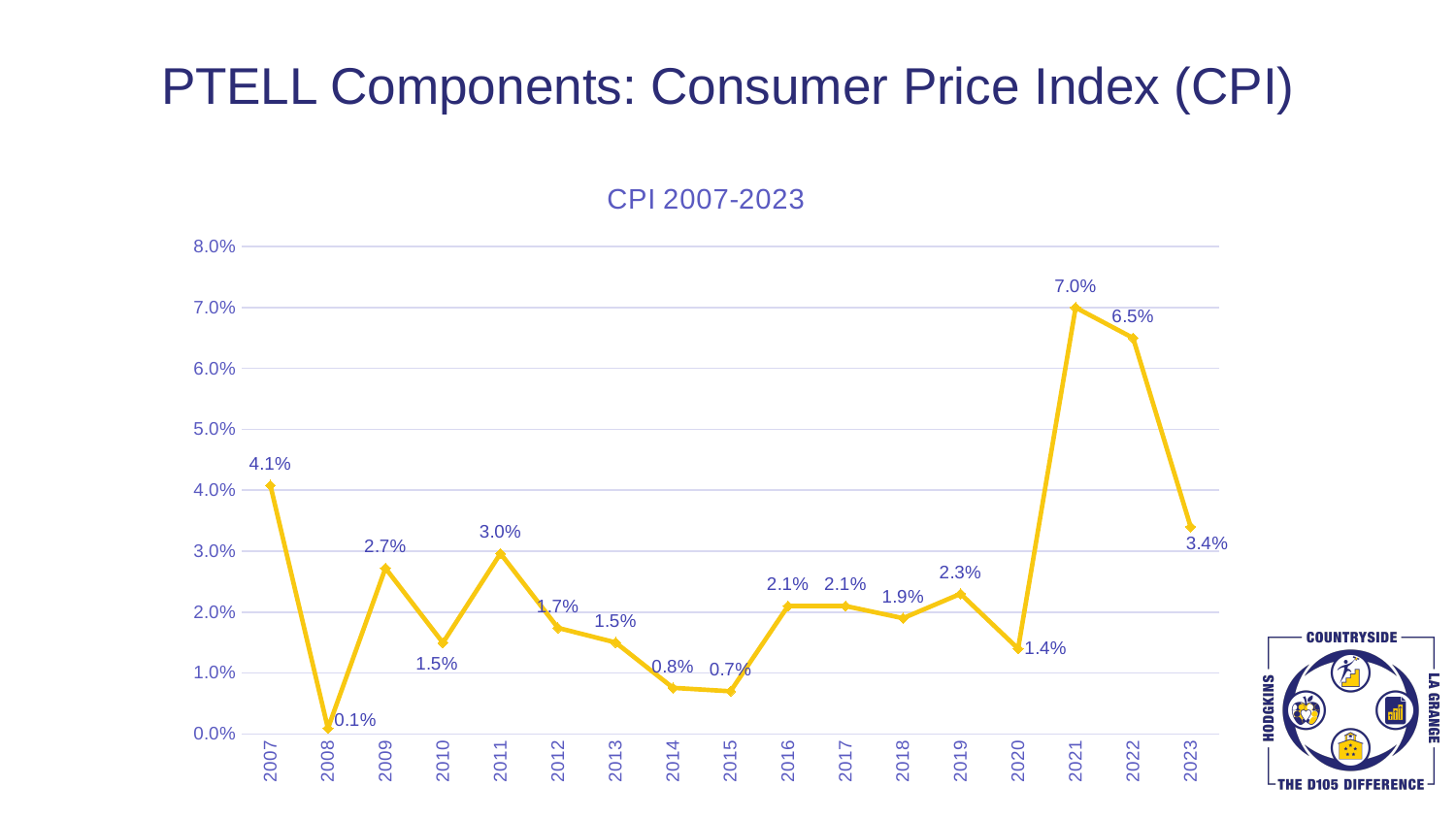
How many years are plotted on the chart? 17 What is the difference between the CPI values for 2021 and 2022? 0.5% What is the title of the chart? CPI 2007-2023 Which year has the highest CPI value? 2021 Which year has a larger CPI value, 2007 or 2011? 2007 What is the CPI value for 2014? 0.8% What is the CPI value for 2023? 3.4% Is the CPI value for 2019 greater or less than 2.0%? greater What kind of chart is shown on the slide? Line chart What is the CPI value for 2021? 7.0% Which year has the lowest CPI value? 2008 What is the CPI value for 2008? 0.1%